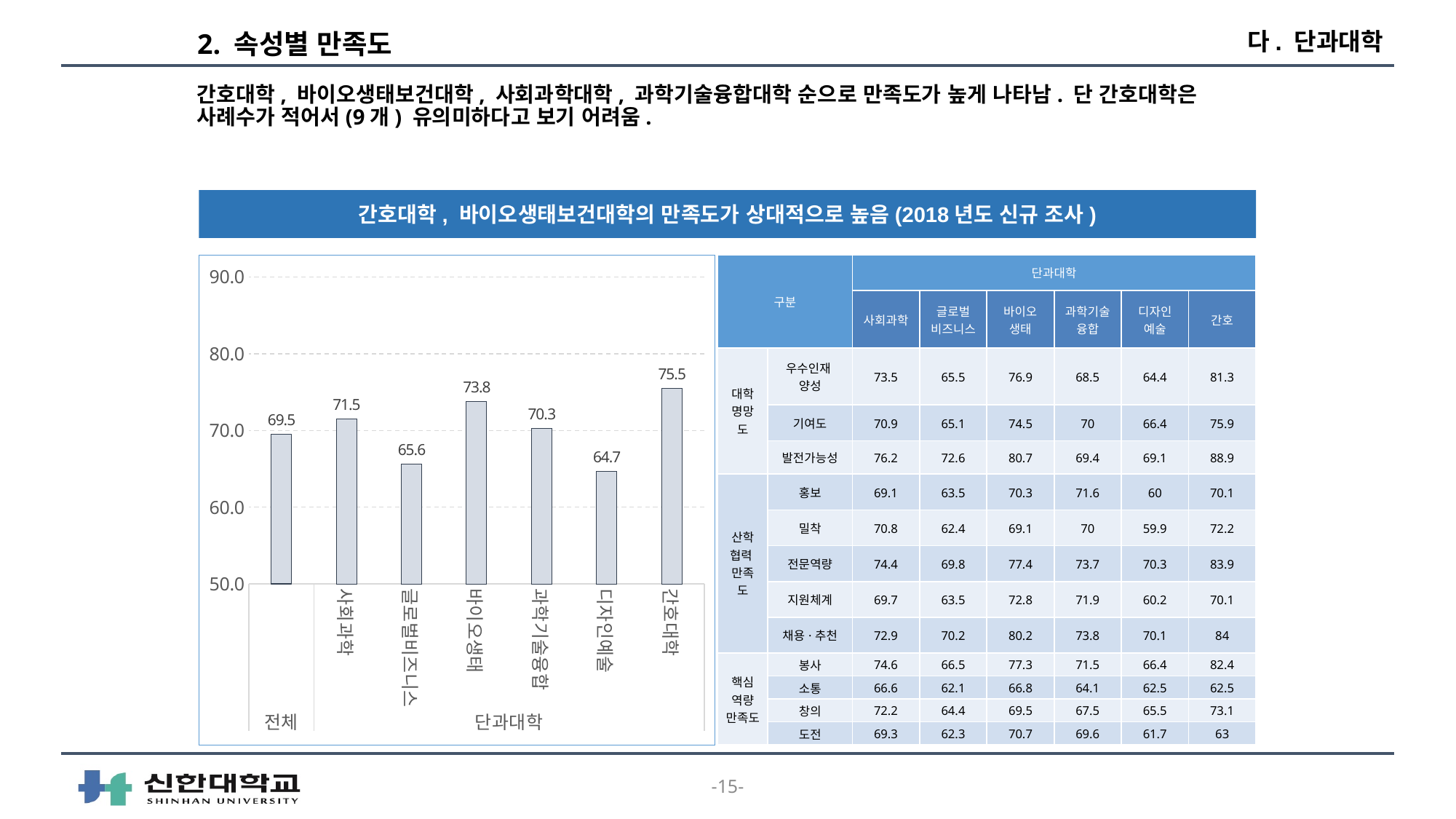
How many bars are plotted in the bar chart? 7 What is the value shown for 과학기술융합 in the bar chart? 70.3 What is the value shown for 전체 in the bar chart? 69.5 Is the value for 디자인예술 in the bar chart greater or less than 70.0? less What is the difference between the values for 간호대학 and 디자인예술 in the bar chart? 10.8 What is the value shown for 글로벌비즈니스 in the bar chart? 65.6 Which category has the highest bar in the chart? 간호대학 What is the value shown for 바이오생태 in the bar chart? 73.8 Which is larger in the bar chart, the value for 바이오생태 or the value for 과학기술융합? 바이오생태 What kind of chart is shown on the left of the slide? bar chart What is the difference between the values for 사회과학 and 전체 in the bar chart? 2.0 Which category has the lowest bar in the chart? 디자인예술